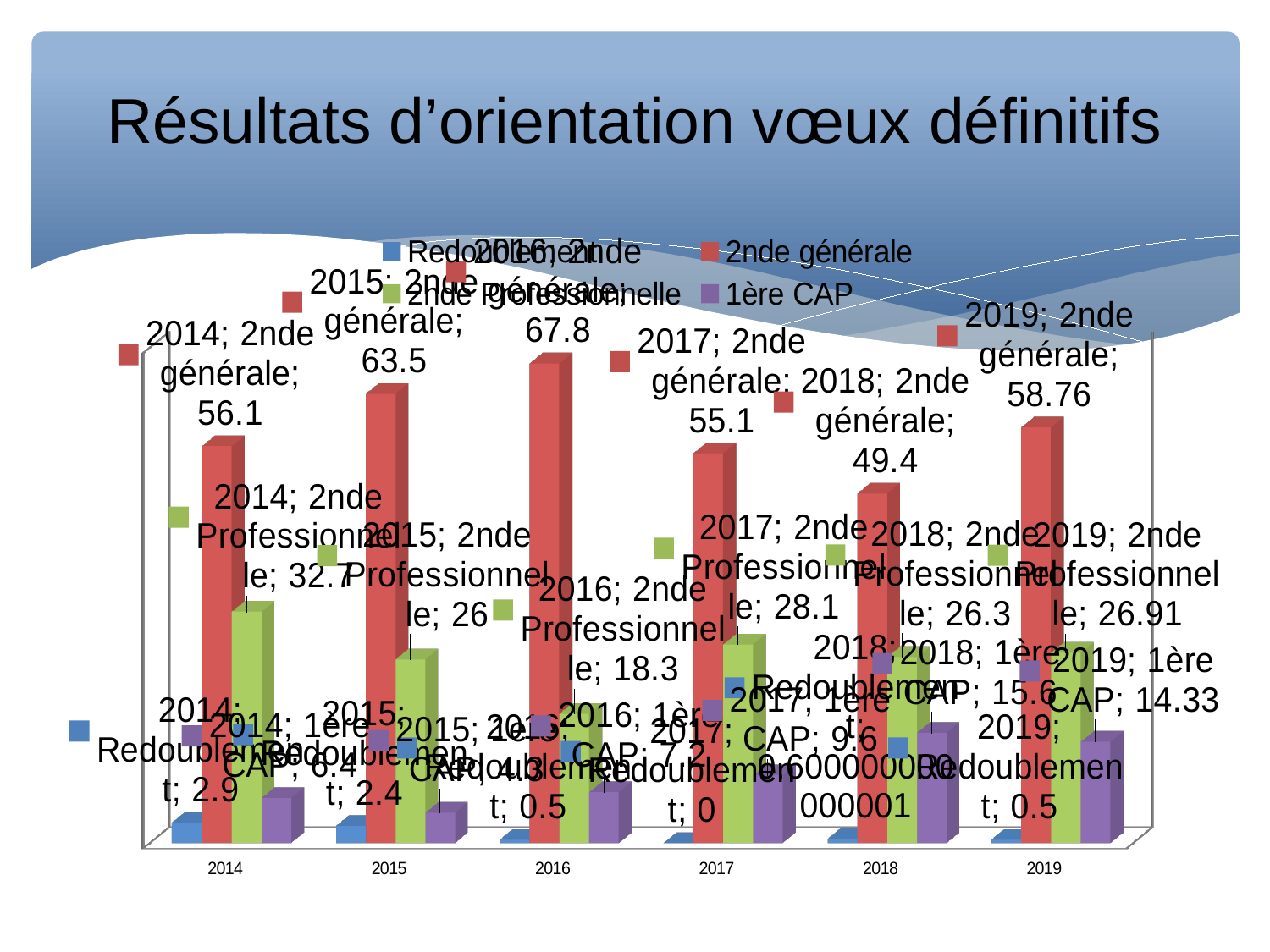
In which year is the 2nde générale value lowest? 2018 In which year is the 2nde générale value highest? 2016 What is the value for 1ère CAP in 2018? 15.6 How many series does the legend list? 4 What is the value for 2nde générale in 2016? 67.8 How many years are shown on the x axis? 6 Which year has the larger 2nde Professionnelle value, 2014 or 2017? 2014 What is the difference between the 2nde générale values for 2016 and 2018? 18.4 What is the title of the slide? Résultats d'orientation vœux définitifs What is the value for 2nde générale in 2019? 58.76 What is the value for 2nde Professionnelle in 2016? 18.3 What kind of chart is shown on the slide? bar chart